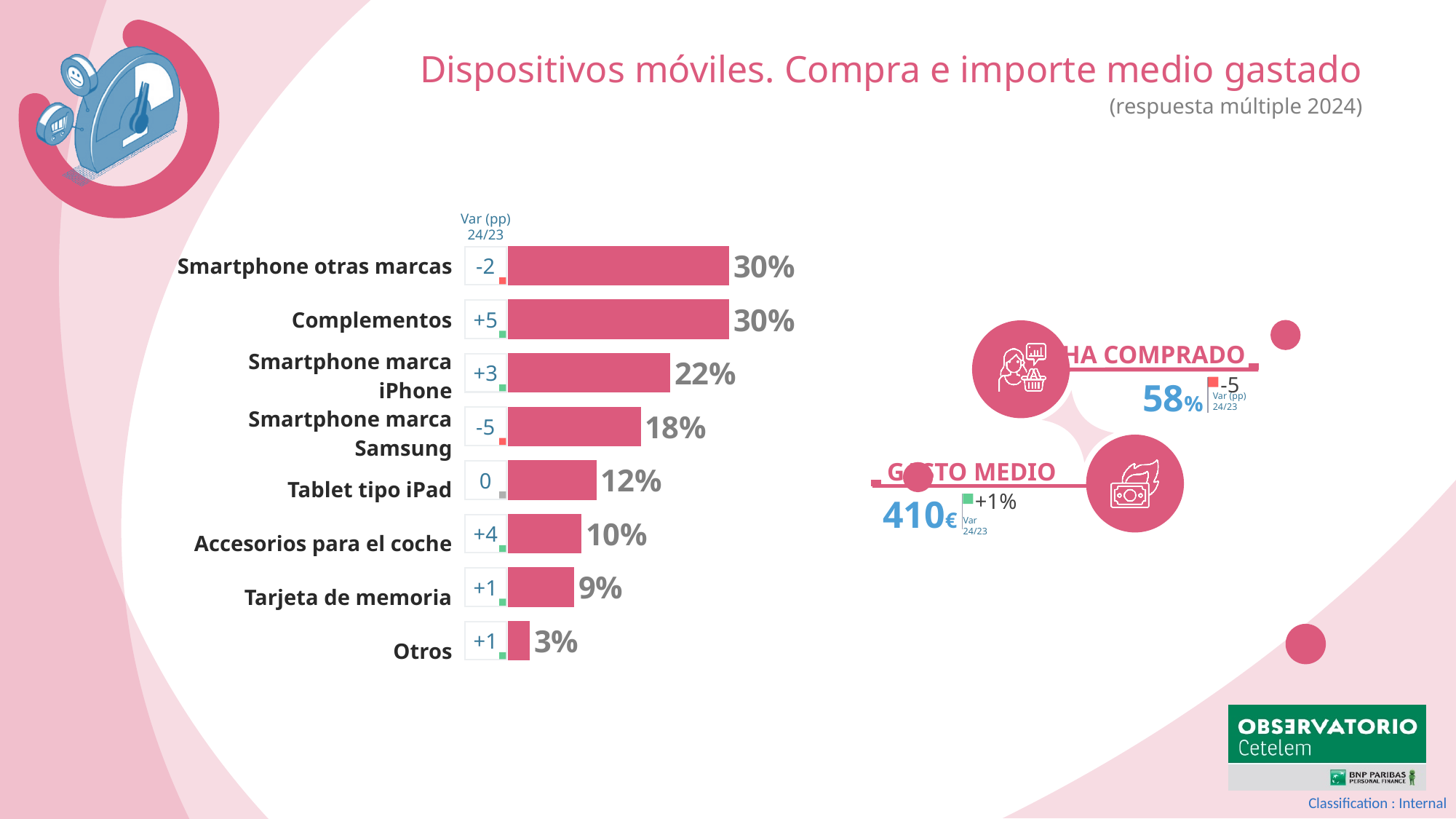
What is the value for Smartphone marca iPhone? 22% What is the value for Tablet tipo iPad? 12% Which is larger, Tarjeta de memoria or Tablet tipo iPad? Tablet tipo iPad What is the difference between Smartphone otras marcas and Otros? 27 percentage points Which category has the lowest value? Otros What is the difference between Smartphone marca iPhone and Smartphone marca Samsung? 4 percentage points What is the Var (pp) 24/23 value shown for Smartphone marca Samsung? -5 What is the title of the slide? Dispositivos móviles. Compra e importe medio gastado What is the Var (pp) 24/23 value shown for Complementos? +5 How many categories are shown in the bar chart? 8 What is the value for Accesorios para el coche? 10% What kind of chart is shown on the slide? Bar chart